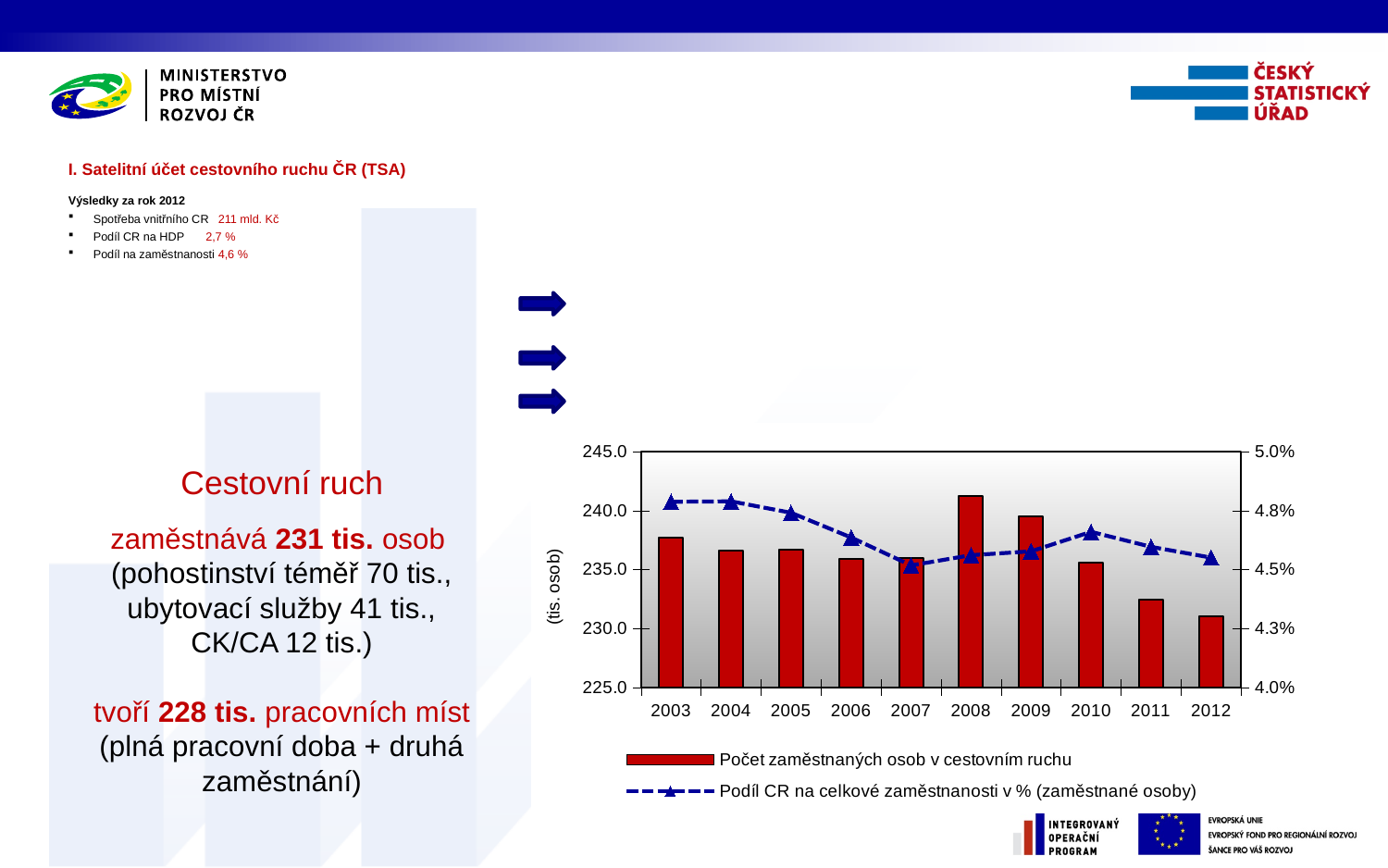
Which year has the larger bar, 2008 or 2012? 2008 Which year has the larger bar, 2003 or 2006? 2003 Is the 'Podíl CR na celkové zaměstnanosti' value for 2007 greater or less than 4.8%? less How many years are shown on the x axis of the chart? 10 Is the bar value for 2008 greater or less than 240.0? greater What is the label on the left vertical axis of the chart? (tis. osob) Do the bars rise or fall from 2009 to 2012? fall In which year is the bar for 'Počet zaměstnaných osob v cestovním ruchu' highest? 2008 Is the bar value for 2012 greater or less than 235.0? less What kind of chart is used for the series 'Počet zaměstnaných osob v cestovním ruchu'? bar chart In which year is the bar for 'Počet zaměstnaných osob v cestovním ruchu' lowest? 2012 How many series does the chart's legend list? 2